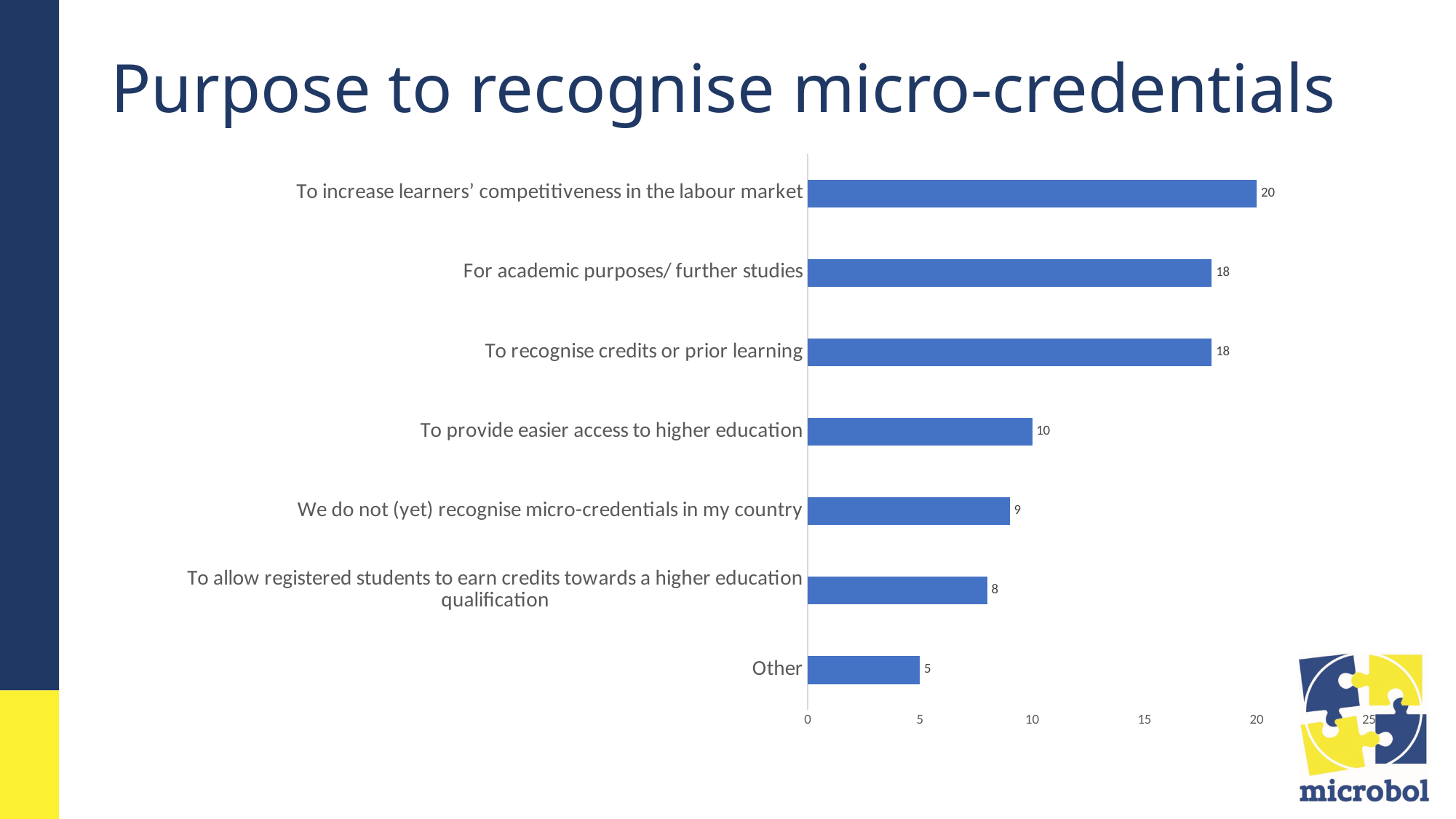
How many categories are shown in the chart? 7 What is the difference between 'To provide easier access to higher education' and 'Other'? 5 Which category has the highest value? To increase learners' competitiveness in the labour market What is the difference between 'To increase learners' competitiveness in the labour market' and 'For academic purposes/ further studies'? 2 What is the value for 'Other'? 5 What is the value for 'To provide easier access to higher education'? 10 Which is larger: 'To provide easier access to higher education' or 'To allow registered students to earn credits towards a higher education qualification'? To provide easier access to higher education What is the title of the slide? Purpose to recognise micro-credentials What kind of chart is shown on the slide? Bar chart What is the value for 'To increase learners' competitiveness in the labour market'? 20 Which category has the lowest value? Other What is the value for 'We do not (yet) recognise micro-credentials in my country'? 9